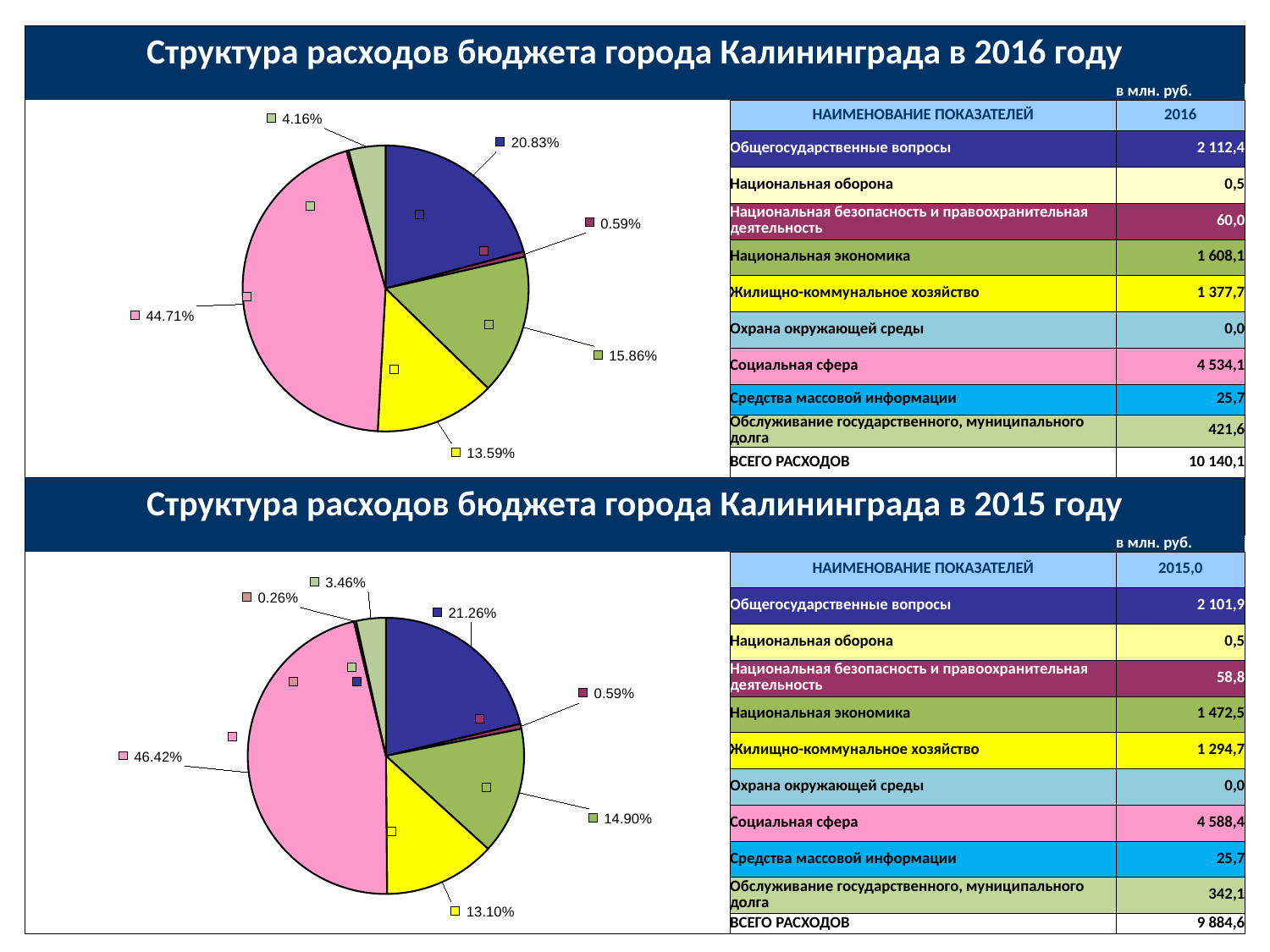
In the 2015 pie chart (bottom), what is the difference between the dark blue slice (21.26%) and the green slice (14.90%)? 6.36% In the 2015 pie chart (bottom), what is the share of the largest slice? 46.42% What is the title above the top pie chart? Структура расходов бюджета города Калининграда в 2016 году In the 2016 pie chart (top), what is the difference between the largest slice (44.71%) and the dark blue slice (20.83%)? 23.88% In the 2016 pie chart (top), what is the share of the largest slice? 44.71% In the 2016 pie chart (top), what is the smallest labelled share? 0.59% How many percentage labels are shown on the 2015 pie chart (bottom)? 7 In the 2016 pie chart (top), what is the share of the dark blue slice? 20.83% In the 2015 pie chart (bottom), what is the smallest labelled share? 0.26% What kind of chart is used on the slide for the 2016 budget structure? pie chart In the 2015 pie chart (bottom), what is the share of the light green slice? 3.46% Which is larger: the yellow slice in the 2016 pie chart (13.59%) or the yellow slice in the 2015 pie chart (13.10%)? 2016 (13.59%)